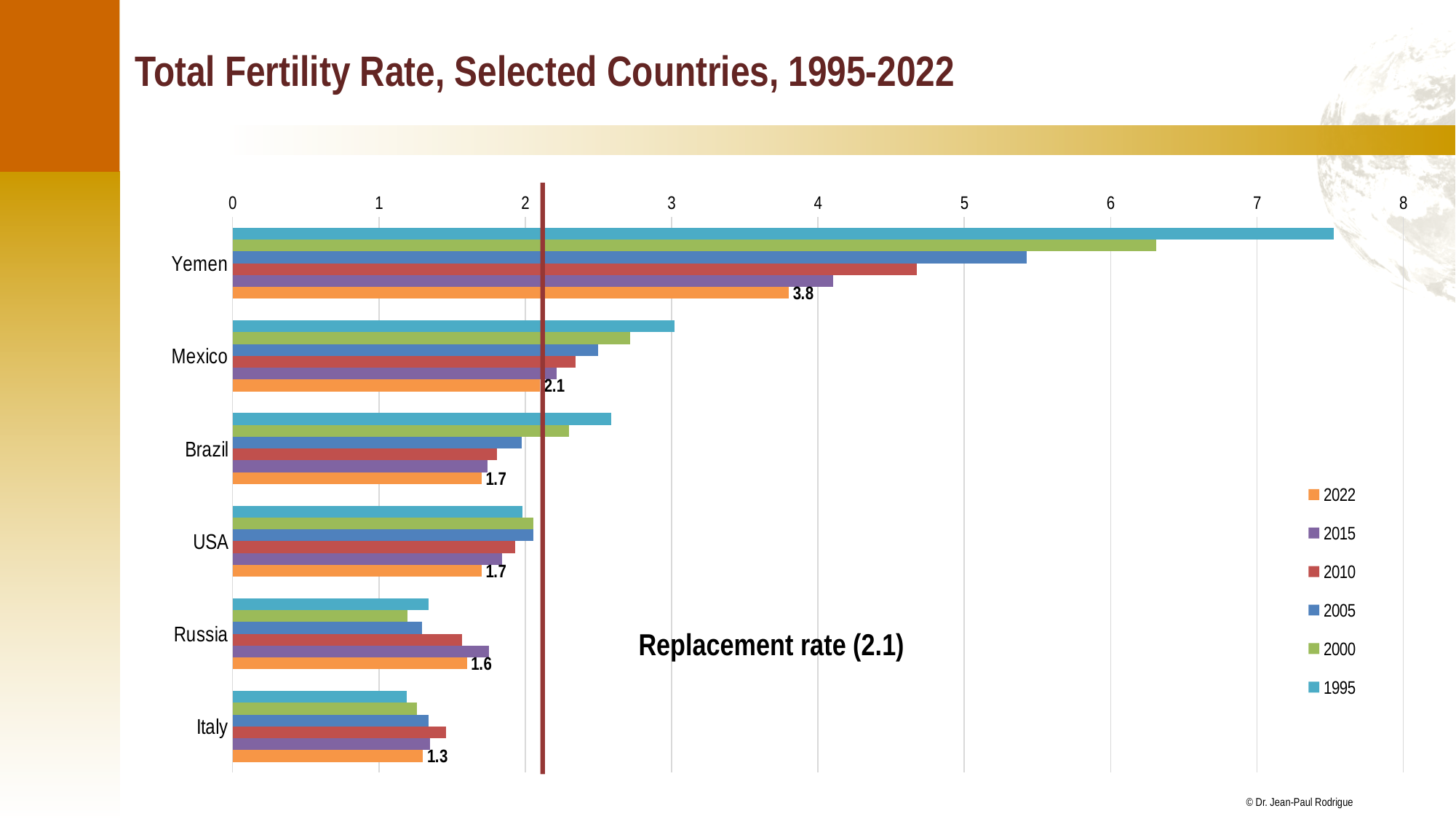
Is the value for Yemen in 1995 greater or less than 7? greater What kind of chart is shown on the slide? bar chart What is the difference between Yemen's and Mexico's 2022 total fertility rates? 1.7 What is the total fertility rate for Russia in 2022? 1.6 Which country has the highest total fertility rate in 2022? Yemen Which country has the lowest total fertility rate in 2022? Italy How many series does the legend list? 6 How many countries are shown on the chart? 6 What is the total fertility rate for Italy in 2022? 1.3 What replacement rate is marked by the vertical line on the chart? 2.1 What is the total fertility rate for Yemen in 2022? 3.8 Do Yemen's total fertility rate values rise or fall from 1995 to 2022? fall